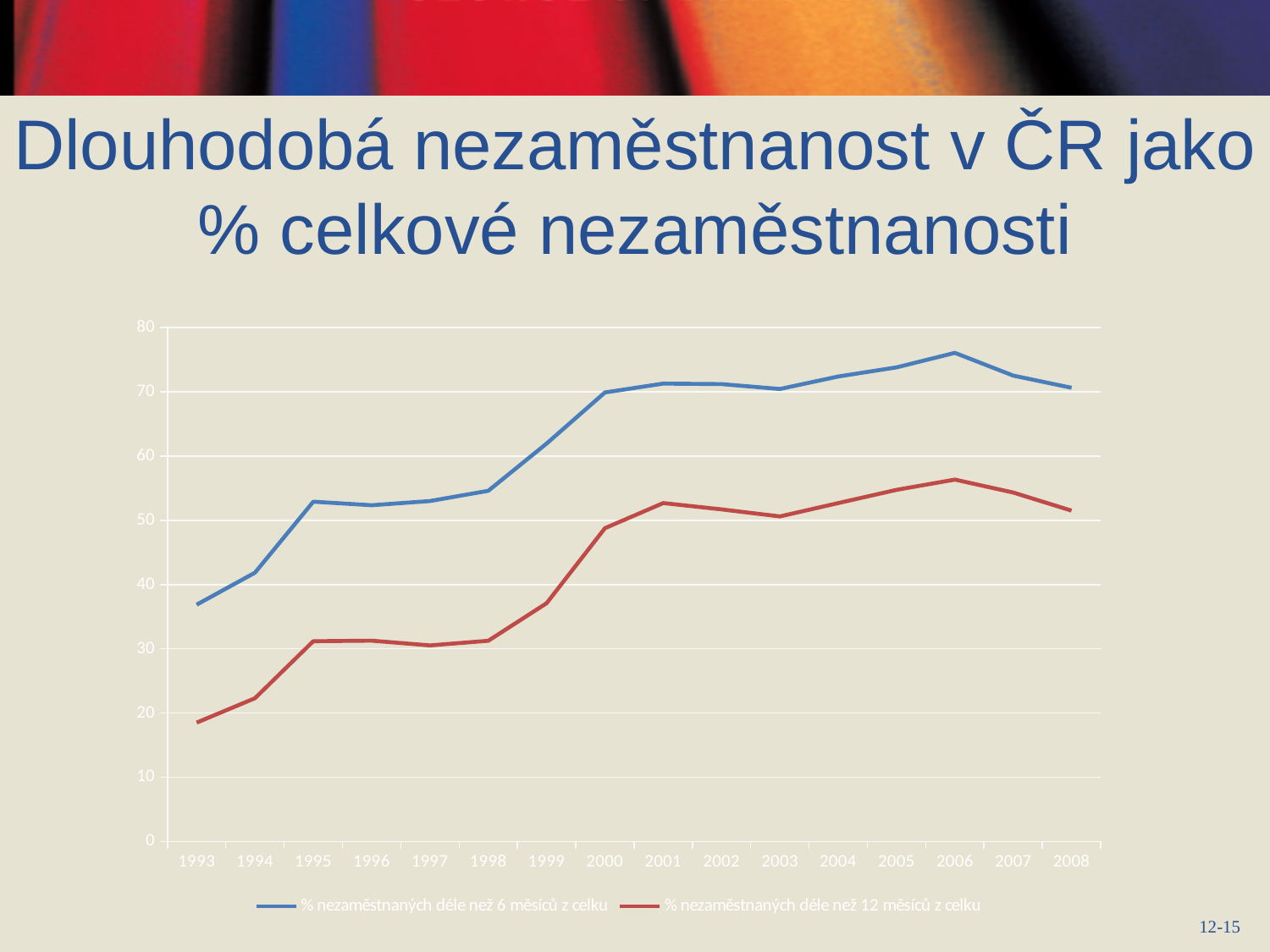
In which year does the series '% nezaměstnaných déle než 6 měsíců z celku' reach its highest value? 2006 Is the value for '% nezaměstnaných déle než 6 měsíců z celku' in 1993 greater or less than 40? less How many years are shown on the x axis? 16 Overall, do the values of '% nezaměstnaných déle než 6 měsíců z celku' rise or fall from 1993 to 2008? rise Is the value for '% nezaměstnaných déle než 12 měsíců z celku' in 1999 greater or less than 40? less How many series does the legend list? 2 Is the value for '% nezaměstnaných déle než 12 měsíců z celku' in 1993 greater or less than 20? less Which series has the higher value in 2000, '% nezaměstnaných déle než 6 měsíců z celku' or '% nezaměstnaných déle než 12 měsíců z celku'? % nezaměstnaných déle než 6 měsíců z celku In which year does the series '% nezaměstnaných déle než 12 měsíců z celku' reach its highest value? 2006 In which year is the series '% nezaměstnaných déle než 12 měsíců z celku' at its lowest? 1993 What kind of chart is shown on the slide? line chart